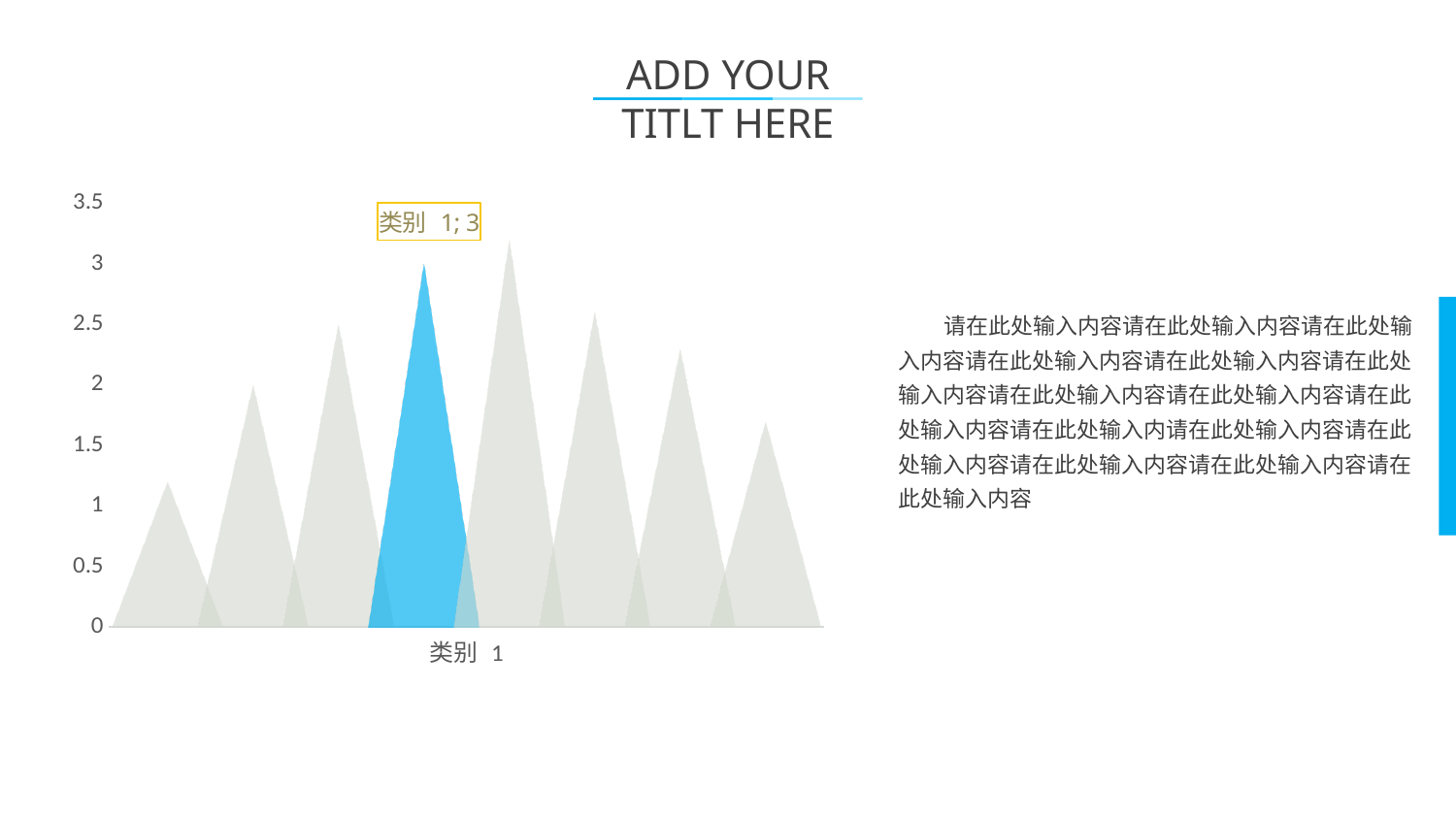
How many triangular bars are plotted in the chart? 8 Which is larger, the blue triangle or the leftmost triangle? the blue triangle Is the value of the second triangle from the left greater or less than 2.5? less Which triangle has the lowest peak, the leftmost or the rightmost? the leftmost What value is shown by the data label on the blue highlighted triangle? 3 Is the value of the rightmost triangle greater or less than 2? less What category label appears on the x axis of the chart? 类别 1 Is the value of the leftmost triangle greater or less than 1.5? less What kind of chart is shown on the slide? bar chart What is the highest tick value shown on the y axis? 3.5 What colour is the highlighted triangle that carries the data label? blue